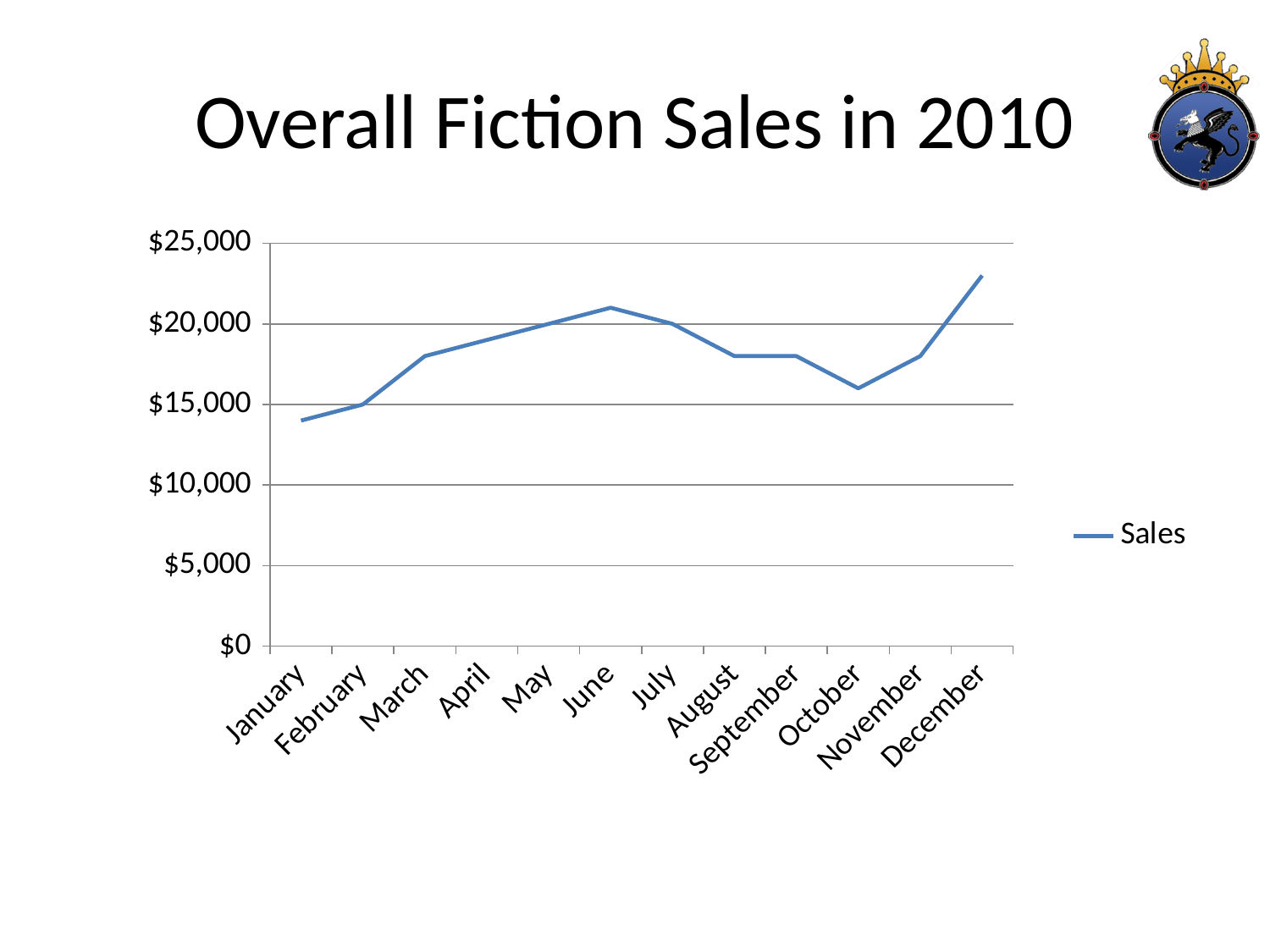
Is the Sales value for December greater or less than $20,000? greater What is the Sales value for February? $15,000 How many months are plotted along the x axis? 12 Do Sales rise or fall from January to June? Rise Is the Sales value for January greater or less than $15,000? less What is the title of the chart? Overall Fiction Sales in 2010 How many series does the legend list? 1 Which month has higher Sales, June or October? June Which month has the lowest Sales value? January What is the Sales value for July? $20,000 What type of chart is shown on the slide? Line chart Which month has the highest Sales value? December